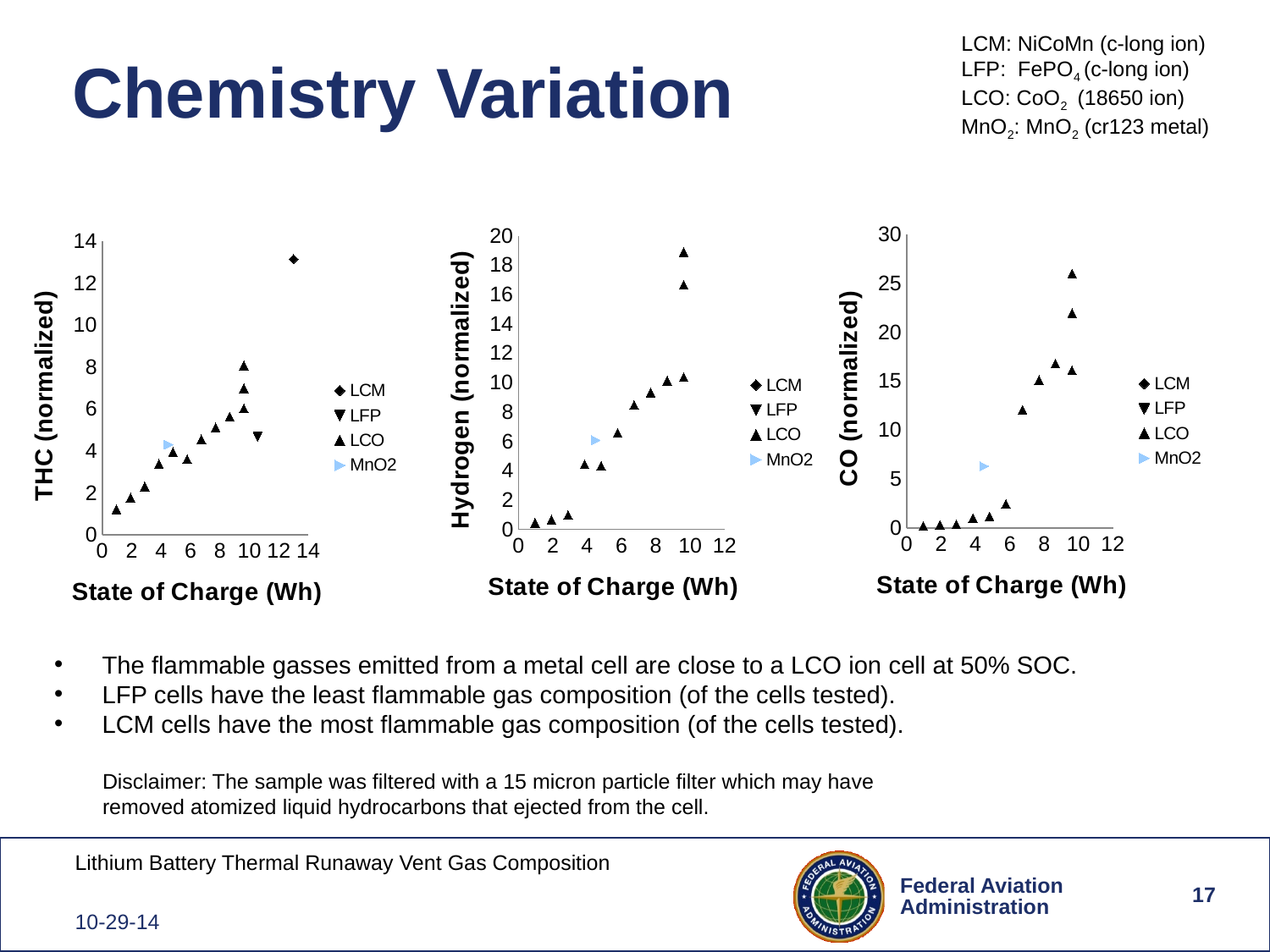
In the Hydrogen (normalized) chart, is the highest LCO value greater or less than 16? greater What is the y-axis title of the middle chart? Hydrogen (normalized) In the THC (normalized) chart, is the LCM value greater or less than 10? greater In the THC (normalized) chart, which series has the highest plotted value? LCM In the Hydrogen (normalized) chart, is the MnO2 value greater or less than 8? less In the Hydrogen (normalized) chart, which series has the highest plotted value? LCO In the CO (normalized) chart, do the LCO values generally rise or fall as State of Charge increases? rise What kind of chart is the THC (normalized) chart on the left? scatter chart How many series does the legend of the Hydrogen (normalized) chart list? 4 What is the x-axis title of the CO (normalized) chart on the right? State of Charge (Wh)